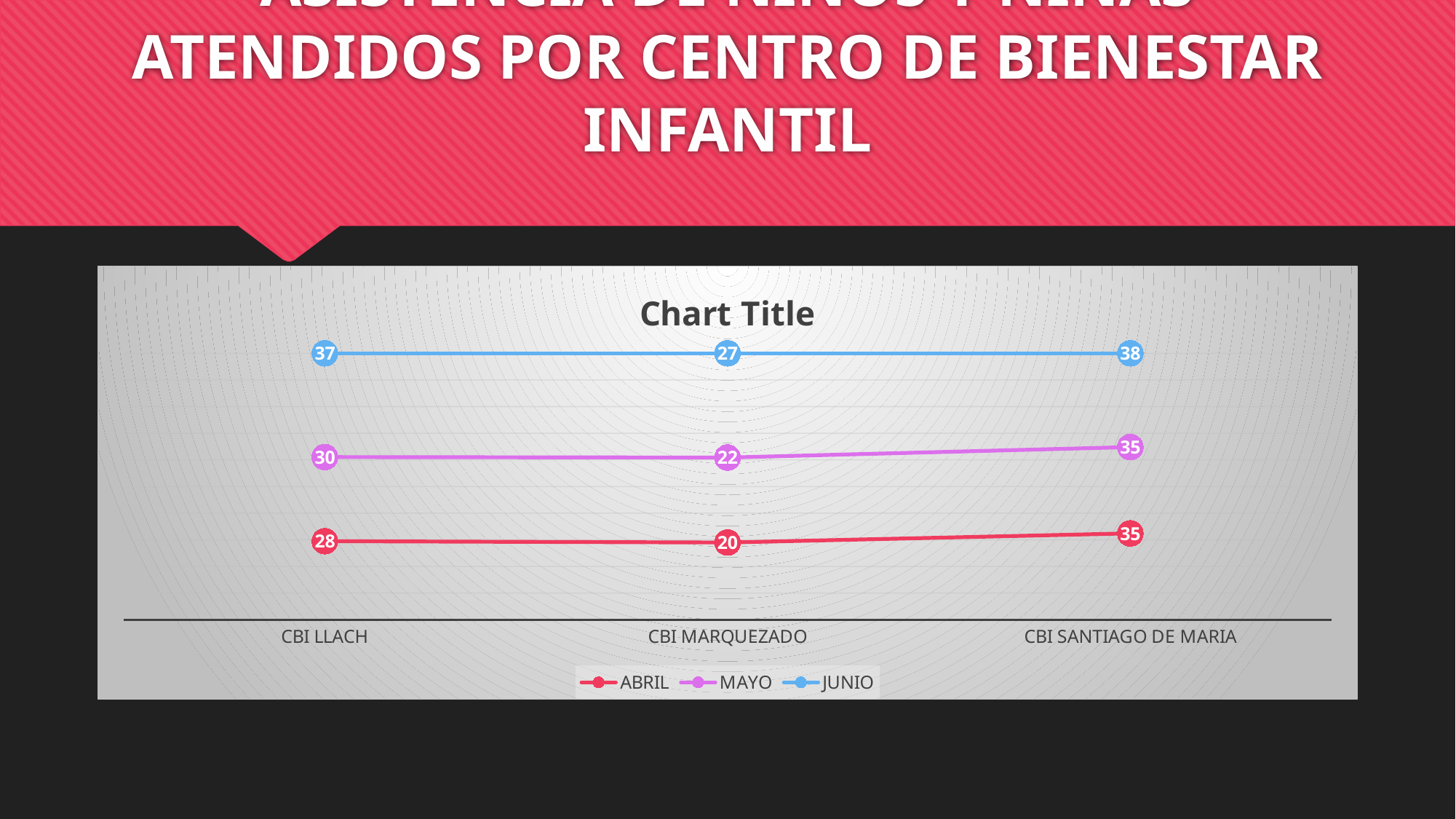
What is the value for JUNIO at CBI SANTIAGO DE MARIA? 38 How many series does the legend list? 3 How many centres are shown on the x axis? 3 What kind of chart is shown? Line chart What is the value for MAYO at CBI MARQUEZADO? 22 What is the difference between the JUNIO values for CBI SANTIAGO DE MARIA and CBI MARQUEZADO? 11 What is the value for ABRIL at CBI LLACH? 28 Which centre has the lowest value for ABRIL? CBI MARQUEZADO Which centre has the highest value for JUNIO? CBI SANTIAGO DE MARIA Which is larger: the MAYO value for CBI LLACH or the MAYO value for CBI MARQUEZADO? CBI LLACH What is the value for JUNIO at CBI LLACH? 37 Which series is drawn in blue? JUNIO